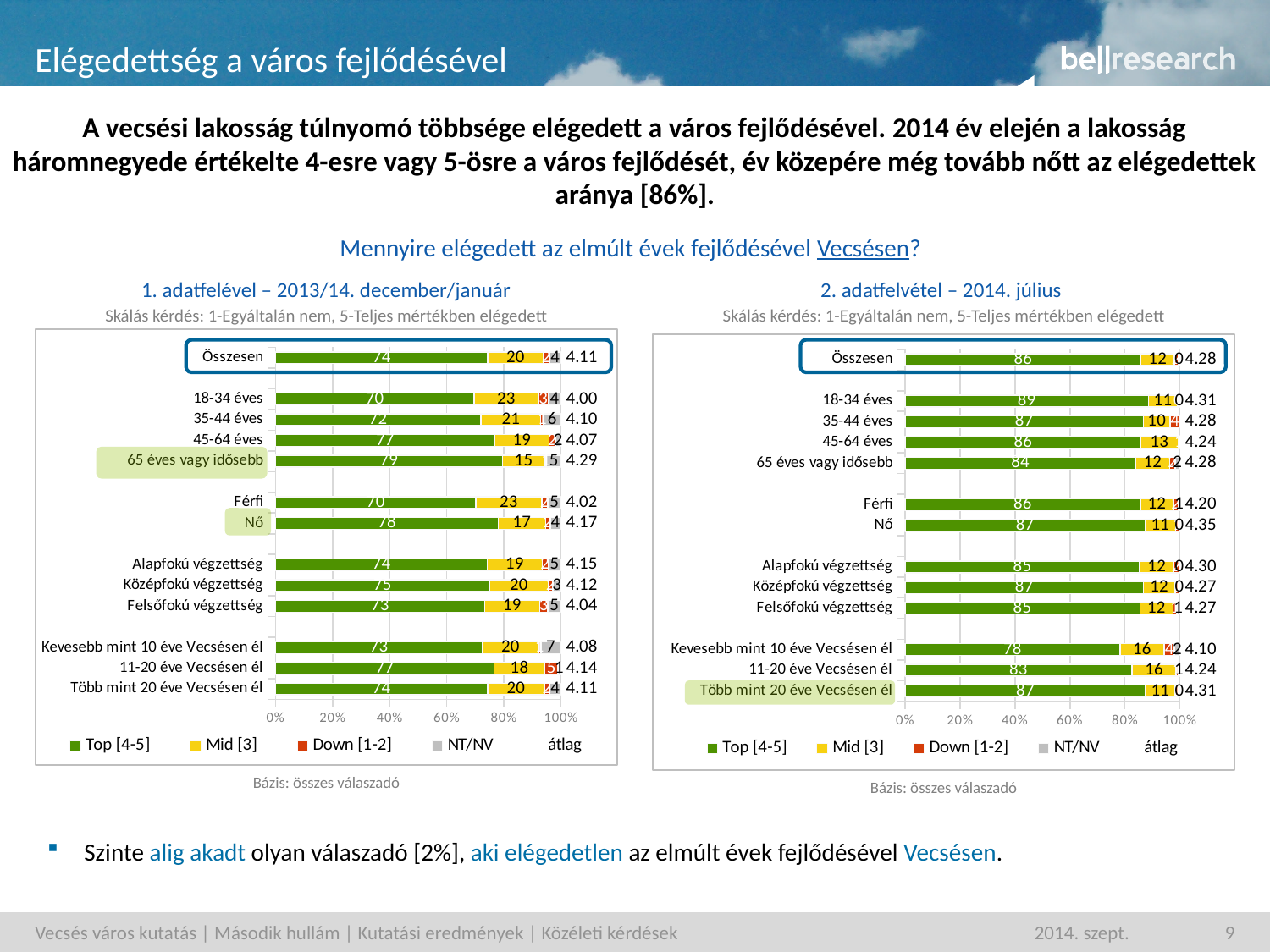
In the right chart (2. adatfelvétel – 2014. július), what is the Top [4-5] value for Összesen? 86 In the left chart (1. adatfelével – 2013/14. december/január), what is the Mid [3] value for 18-34 éves? 23 In the left chart (1. adatfelével – 2013/14. december/január), which category has the highest Top [4-5] value? 65 éves vagy idősebb In the right chart (2. adatfelvétel – 2014. július), what is the átlag value for Nő? 4.35 In the left chart (1. adatfelével – 2013/14. december/január), what is the átlag value for 18-34 éves? 4.00 In the right chart (2. adatfelvétel – 2014. július), which has a higher Top [4-5] value: 18-34 éves or 65 éves vagy idősebb? 18-34 éves How many series does the legend of the left chart (1. adatfelével – 2013/14. december/január) list, including átlag? 5 In the left chart (1. adatfelével – 2013/14. december/január), what is the Top [4-5] value for Összesen? 74 What type of chart is the right chart (2. adatfelvétel – 2014. július)? Stacked bar chart In the left chart (1. adatfelével – 2013/14. december/január), what is the difference between the Top [4-5] values for Nő and Férfi? 8 In the right chart (2. adatfelvétel – 2014. július), which category has the lowest Top [4-5] value? Kevesebb mint 10 éve Vecsésen él In the right chart (2. adatfelvétel – 2014. július), what is the Mid [3] value for Kevesebb mint 10 éve Vecsésen él? 16